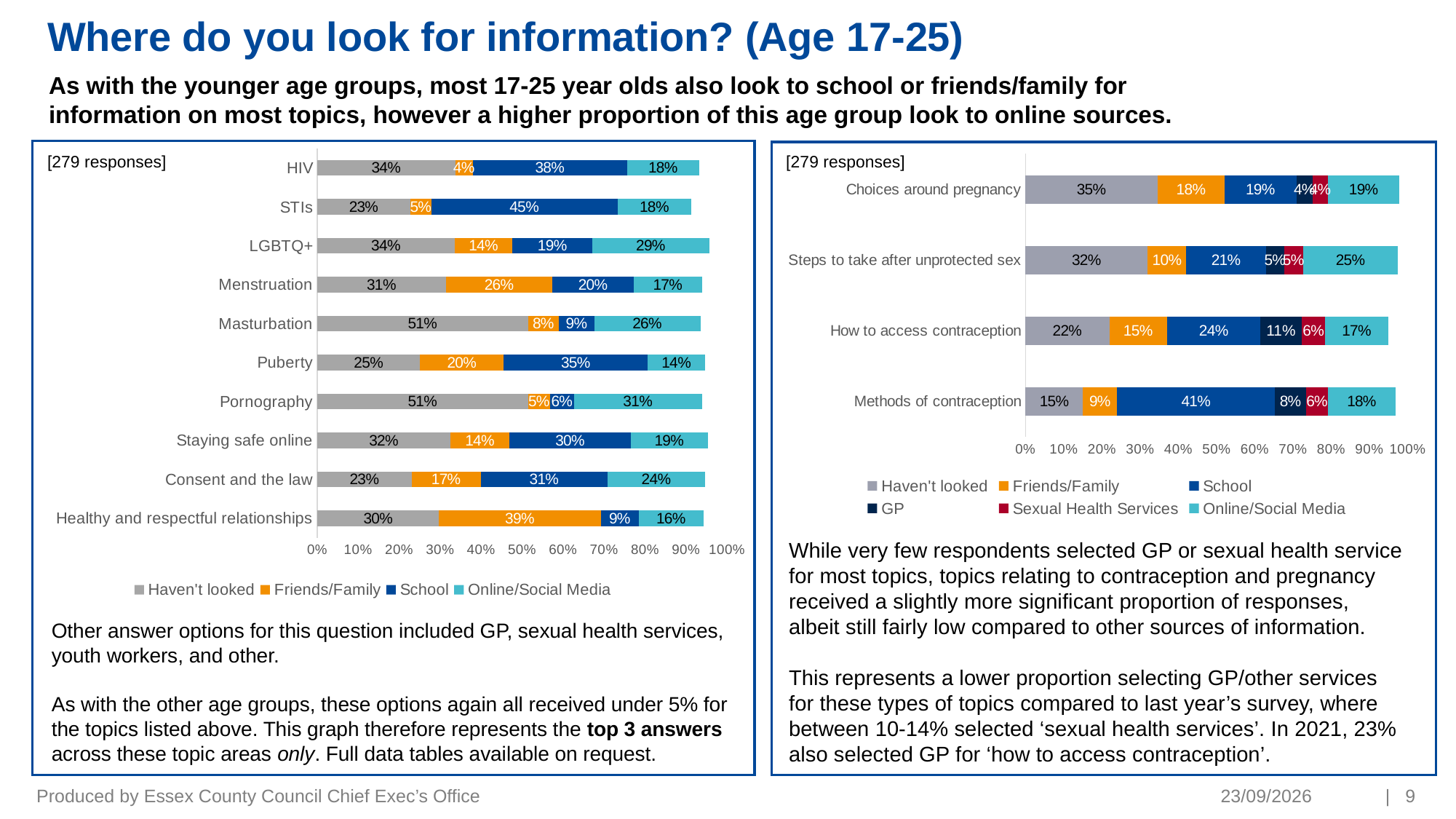
In the left chart, which topic has the lowest Friends/Family percentage? HIV In the left chart, what percentage of respondents selected School for STIs? 45% In the left chart, which topic has the highest Online/Social Media percentage? Pornography How many series does the legend of the right chart list? 6 In the right chart, what percentage selected School for Methods of contraception? 41% In the right chart, what percentage selected GP for How to access contraception? 11% In the right chart, which topic has the highest Online/Social Media percentage? Steps to take after unprotected sex How many topics are shown in the left chart? 10 What type of chart is the right chart? Stacked bar chart In the left chart, what is the difference between the School percentages for Puberty and Masturbation? 26% In the left chart, what percentage selected Friends/Family for Healthy and respectful relationships? 39% In the left chart, which is larger: the Haven't looked percentage for Menstruation or for Consent and the law? Menstruation